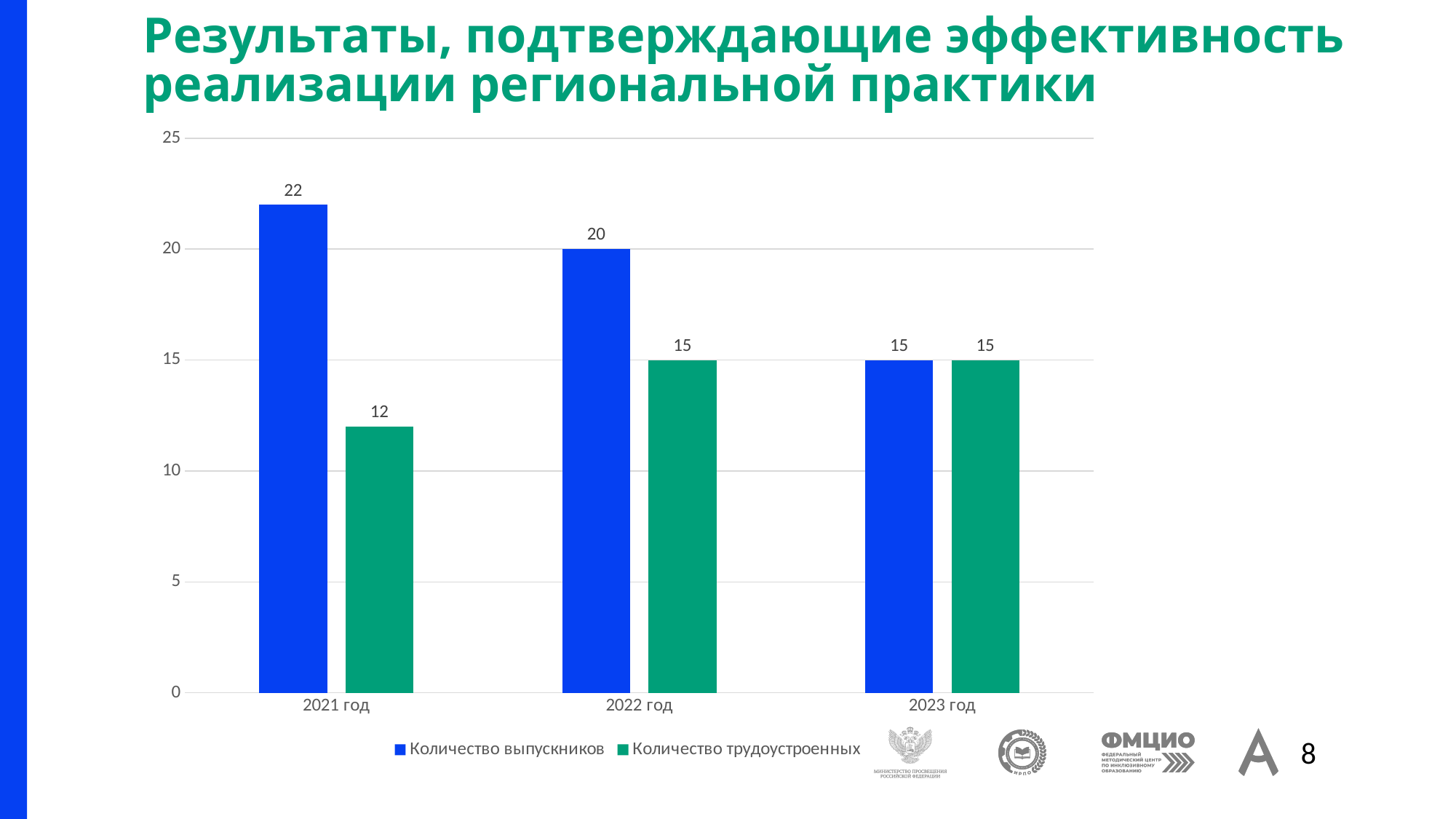
What is the value of Количество выпускников for 2022 год? 20 In which year is Количество трудоустроенных the lowest? 2021 год How many series does the legend list? 2 Does Количество выпускников rise or fall from 2021 год to 2023 год? Fall In which year is Количество выпускников the highest? 2021 год What is the value of Количество выпускников for 2021 год? 22 What kind of chart is shown on the slide? Bar chart What is the value of Количество трудоустроенных for 2021 год? 12 What is the value of Количество трудоустроенных for 2023 год? 15 What is the difference between Количество выпускников and Количество трудоустроенных in 2021 год? 10 How many years are shown on the x axis? 3 Which is larger in 2022 год: Количество выпускников or Количество трудоустроенных? Количество выпускников